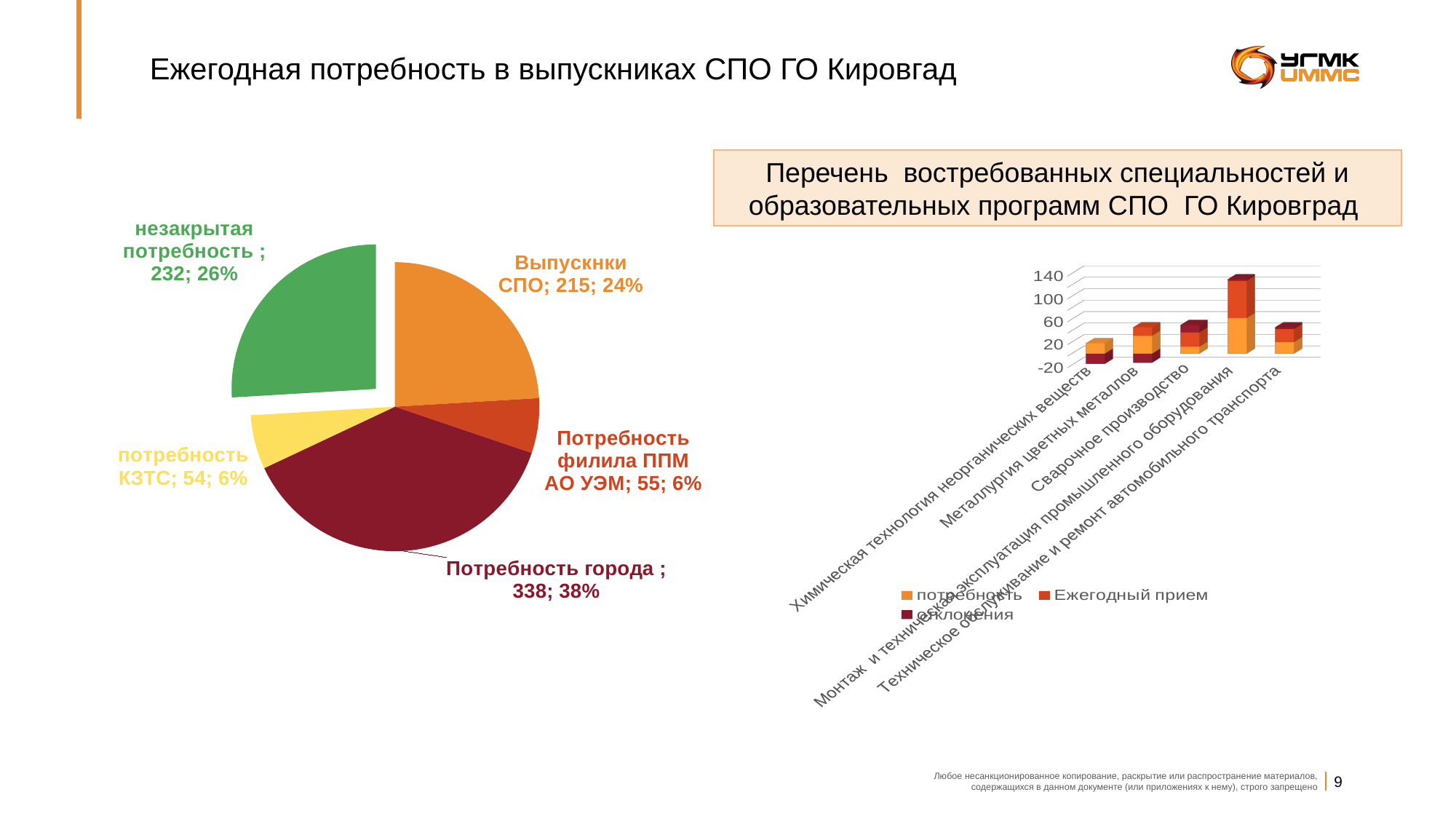
In the bar chart on the right, how many series does the legend list? 3 In the pie chart on the left, what is the value for Потребность города? 338; 38% In the pie chart on the left, what share does незакрытая потребность have? 26% In the pie chart on the left, how many slices are there? 5 In the bar chart on the right, is the top of the bar for Монтаж и техническая эксплуатация промышленного оборудования greater or less than 100? greater In the bar chart on the right, which category has the tallest bar? Монтаж и техническая эксплуатация промышленного оборудования In the pie chart on the left, which is larger: незакрытая потребность or Выпускнки СПО? незакрытая потребность In the pie chart on the left, which category has the largest slice? Потребность города In the pie chart on the left, what is the difference between Потребность города and Выпускнки СПО? 123 In the pie chart on the left, what is the value for потребность КЗТС? 54; 6% What kind of chart is shown on the right side of the slide? bar chart In the pie chart on the left, what is the value for Выпускнки СПО? 215; 24%